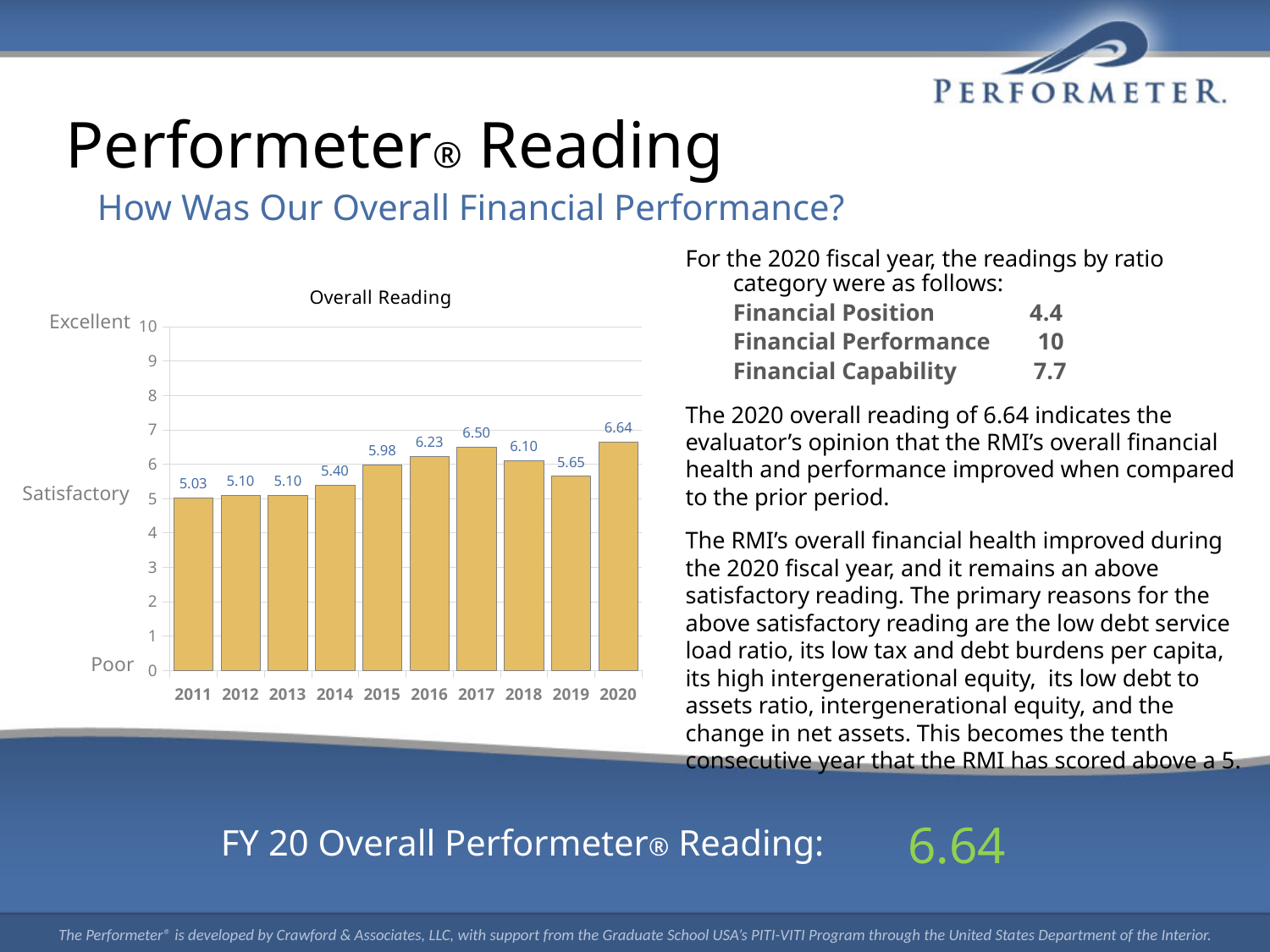
Which year has the lowest Overall Reading? 2011 How many years are shown on the x axis of the Overall Reading chart? 10 What kind of chart is the Overall Reading chart? bar chart Did the Overall Reading rise or fall from 2017 to 2019? fall Which year has the highest Overall Reading? 2020 What is the difference between the Overall Reading for 2020 and 2019? 0.99 What is the Overall Reading value for 2017? 6.50 What is the title of the chart on the slide? Overall Reading What is the Overall Reading value for 2011? 5.03 Which year has a higher Overall Reading, 2016 or 2018? 2016 Is the Overall Reading for 2014 greater or less than 5? greater What is the Overall Reading value for 2020? 6.64